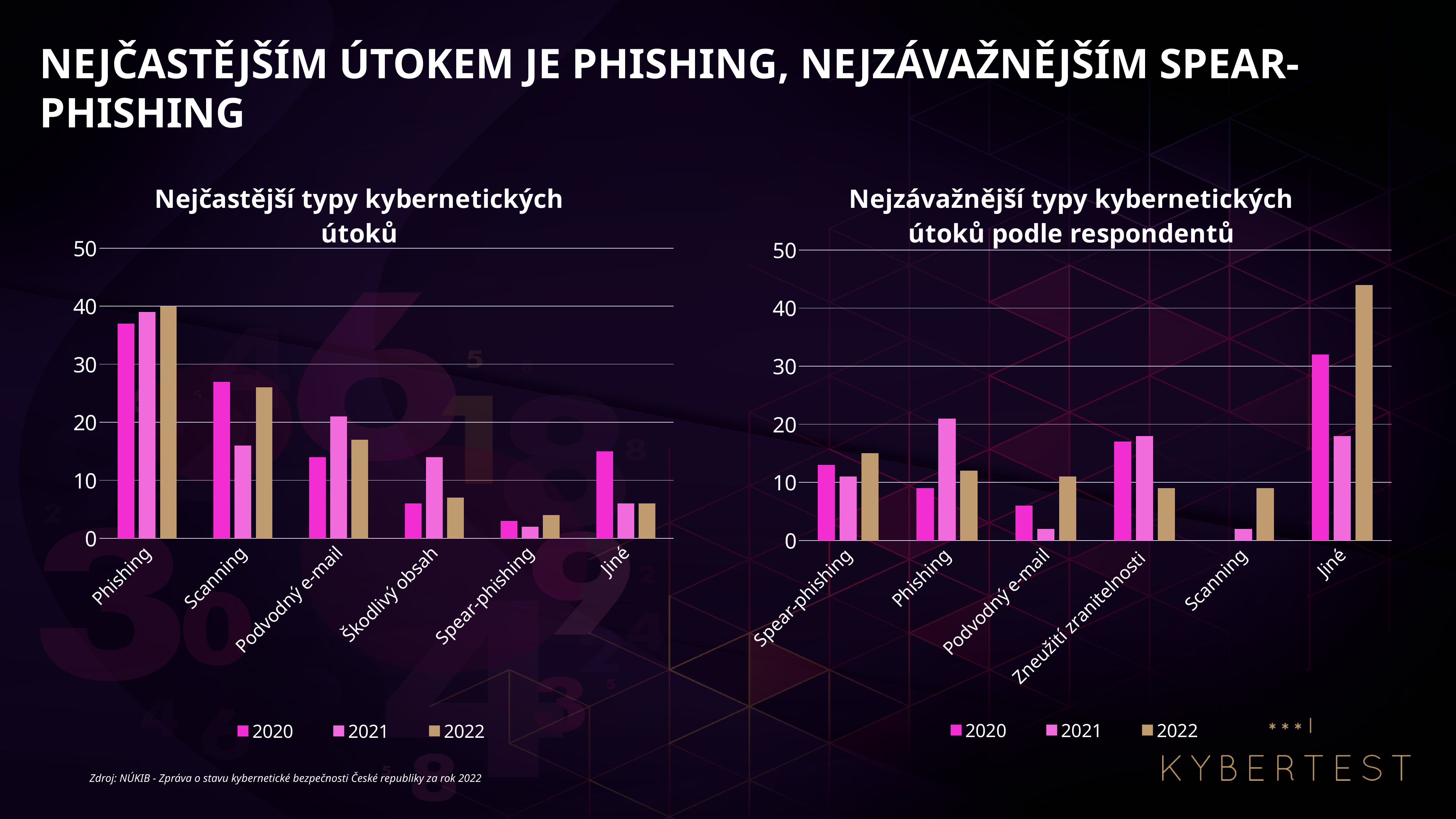
In the left chart, "Nejčastější typy kybernetických útoků", which category has the highest 2022 value? Phishing In the left chart, "Nejčastější typy kybernetických útoků", is the 2020 value for Scanning greater or less than 20? greater In the right chart, "Nejzávažnější typy kybernetických útoků podle respondentů", which is larger for Phishing: the 2020 value or the 2021 value? 2021 What kind of chart is the left chart, "Nejčastější typy kybernetických útoků"? bar chart In the right chart, "Nejzávažnější typy kybernetických útoků podle respondentů", is the 2022 value for Jiné greater or less than 40? greater In the right chart, "Nejzávažnější typy kybernetických útoků podle respondentů", which category has the highest 2022 value? Jiné How many series does the legend of the right chart, "Nejzávažnější typy kybernetických útoků podle respondentů", list? 3 In the right chart, "Nejzávažnější typy kybernetických útoků podle respondentů", which category has the highest 2020 value? Jiné In the left chart, "Nejčastější typy kybernetických útoků", is the 2020 value for Spear-phishing greater or less than 10? less How many categories are shown on the x axis of the left chart, "Nejčastější typy kybernetických útoků"? 6 In the left chart, "Nejčastější typy kybernetických útoků", which is larger for Scanning: the 2020 value or the 2021 value? 2020 What are the legend entries of the left chart, "Nejčastější typy kybernetických útoků"? 2020, 2021, 2022